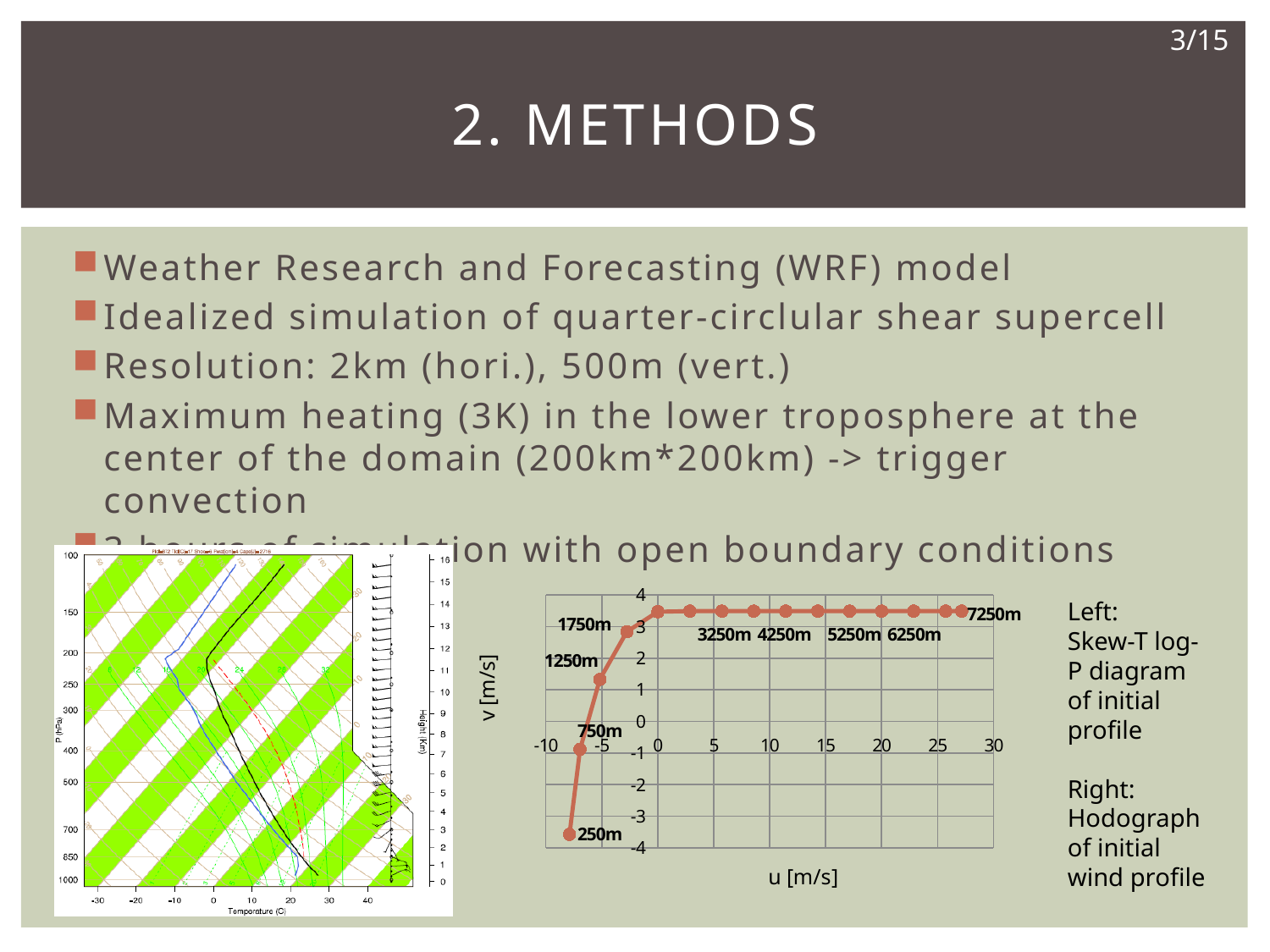
On the hodograph on the right, what is the label of the x axis? u [m/s] What kind of chart is the hodograph on the right of the slide? line chart On the hodograph on the right, what is the label of the y axis? v [m/s] On the hodograph on the right, is the u value for 250m greater or less than -5? less On the hodograph on the right, which labelled height has the highest u value? 7250m On the hodograph on the right, which labelled height has the lowest u value? 250m On the hodograph on the right, is the v value for 750m greater or less than 0? less On the hodograph on the right, is the v value for 250m greater or less than -3? less On the hodograph on the right, does v rise or fall as u increases from -10 to 0? rise On the hodograph on the right, which labelled height has the lowest v value? 250m On the hodograph on the right, which has the larger v value, 250m or 7250m? 7250m